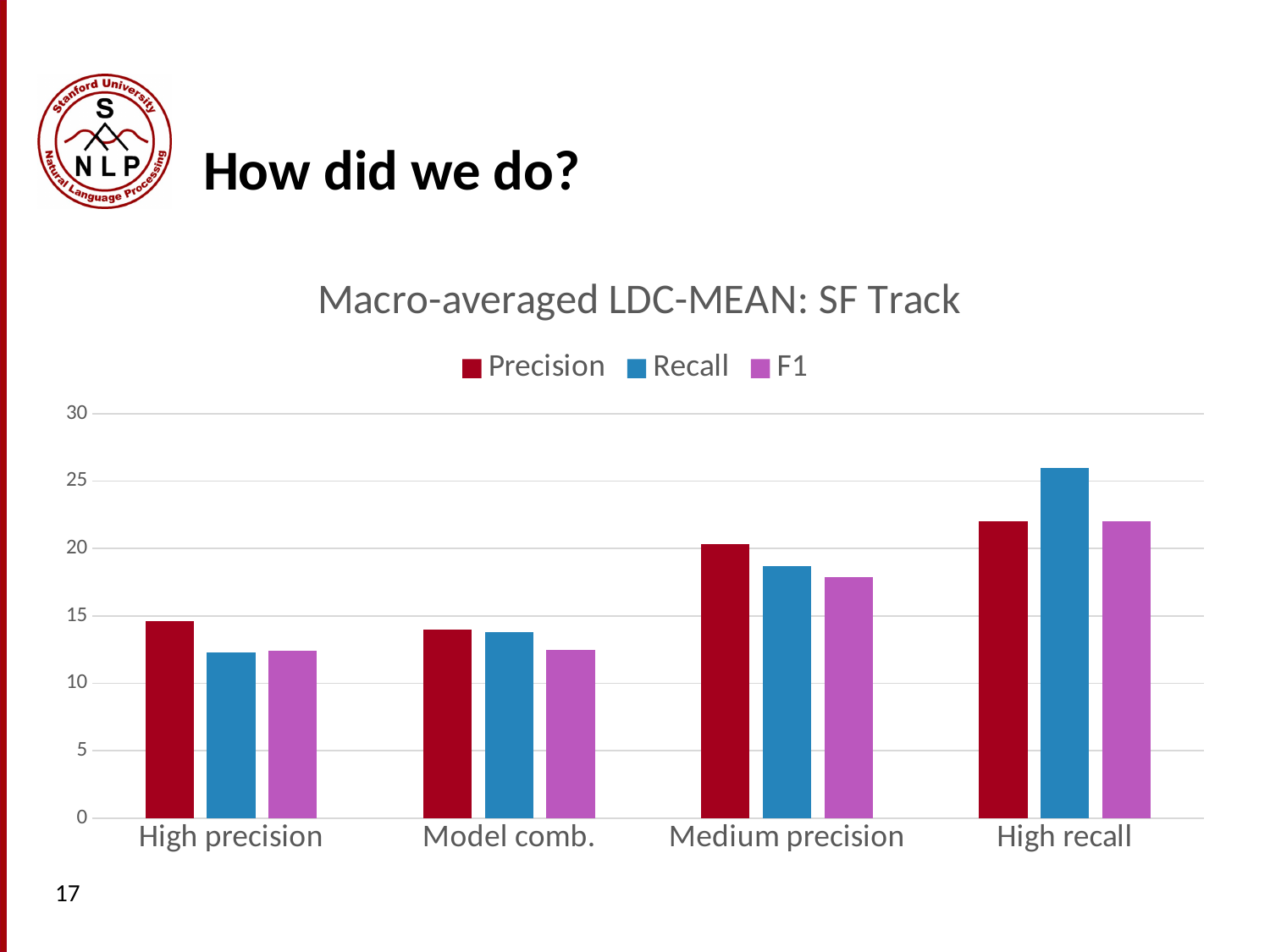
Does the Recall series rise or fall from High precision to High recall along the x axis? rise For Medium precision, which is larger: Precision or Recall? Precision How many categories are shown on the x axis? 4 Which category has the highest Recall value? High recall Is the Recall value for Medium precision greater or less than 20? less What kind of chart is shown on the slide? bar chart Is the F1 value for High recall greater or less than 20? greater Which category has the highest Precision value? High recall How many series does the legend list? 3 Which category has the lowest Recall value? High precision What is the title of the chart? Macro-averaged LDC-MEAN: SF Track For High recall, which is larger: Recall or F1? Recall